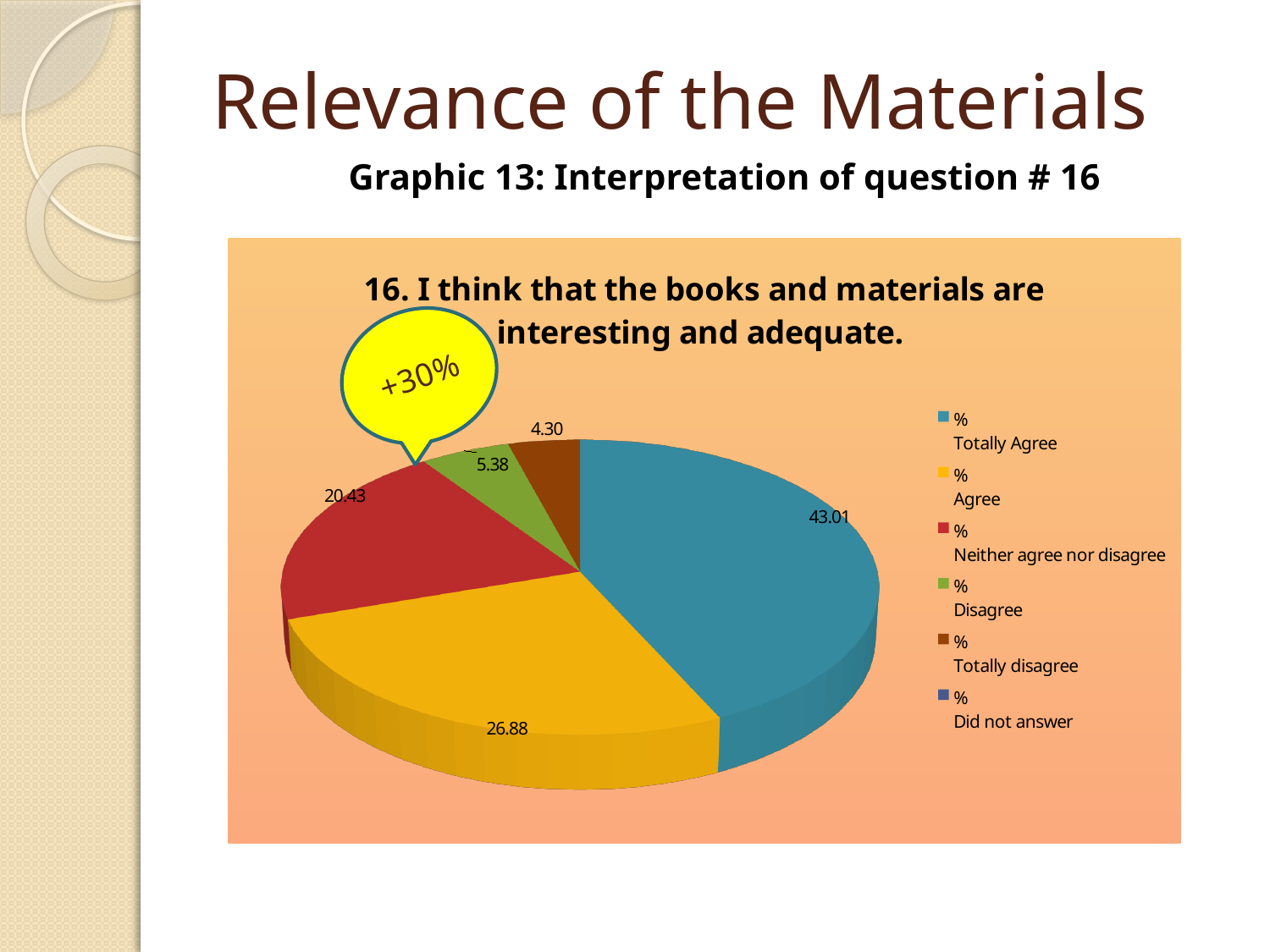
What is the difference between the Disagree value and the Totally disagree value? 1.08 Which category has the largest slice of the pie? Totally Agree What is the value shown for the Neither agree nor disagree slice? 20.43 How many entries does the chart legend list? 6 What is the value shown for the Disagree slice? 5.38 Which is larger, the Agree slice or the Neither agree nor disagree slice? Agree What kind of chart is shown on the slide? Pie chart What is the value shown for the Agree slice? 26.88 What is the value shown for the Totally disagree slice? 4.30 What is the value shown for the Totally Agree slice? 43.01 Which of the labelled slices has the smallest value? Totally disagree What is the difference between the Totally Agree value and the Agree value? 16.13